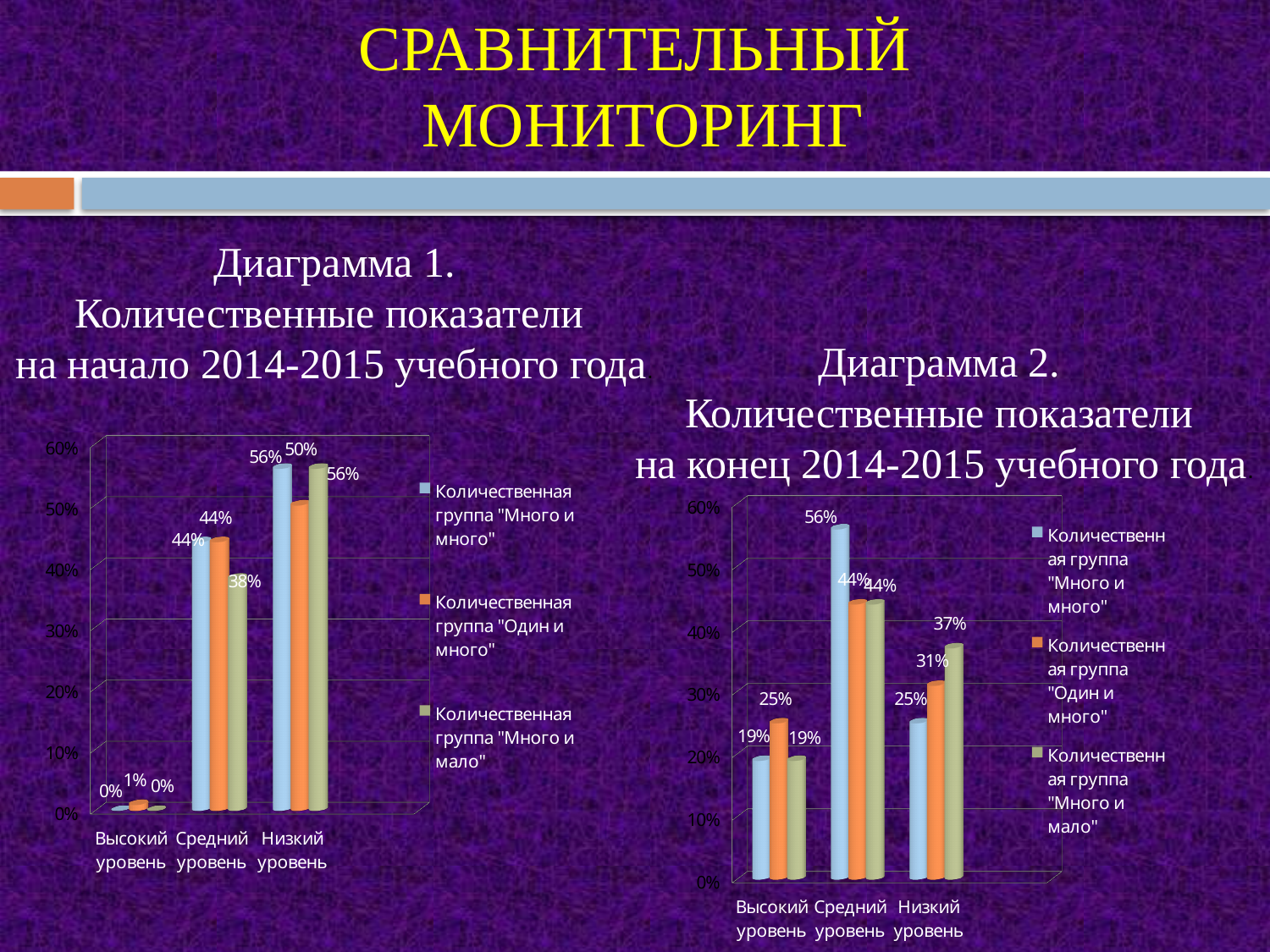
In Диаграмма 2 (right chart), what is the value for Количественная группа "Много и мало" at Низкий уровень? 37% In Диаграмма 1 (left chart), what is the value for Количественная группа "Один и много" at Низкий уровень? 50% In Диаграмма 2 (right chart), which level has the highest value for Количественная группа "Один и много"? Средний уровень In Диаграмма 2 (right chart), what is the value for Количественная группа "Много и много" at Средний уровень? 56% In Диаграмма 1 (left chart), which level has the lowest value for Количественная группа "Много и много"? Высокий уровень How many categories are shown on the x axis of Диаграмма 1 (left chart)? 3 How many series does the legend of Диаграмма 2 (right chart) list? 3 What kind of chart is Диаграмма 2 (right chart)? Bar chart In Диаграмма 2 (right chart), what is the difference between the "Много и мало" value and the "Много и много" value at Низкий уровень? 12% In Диаграмма 1 (left chart), what is the value for Количественная группа "Один и много" at Высокий уровень? 1% In Диаграмма 1 (left chart), what is the value for Количественная группа "Много и мало" at Средний уровень? 38% In Диаграмма 1 (left chart), which is larger at Средний уровень: the value for "Много и много" or for "Много и мало"? Много и много